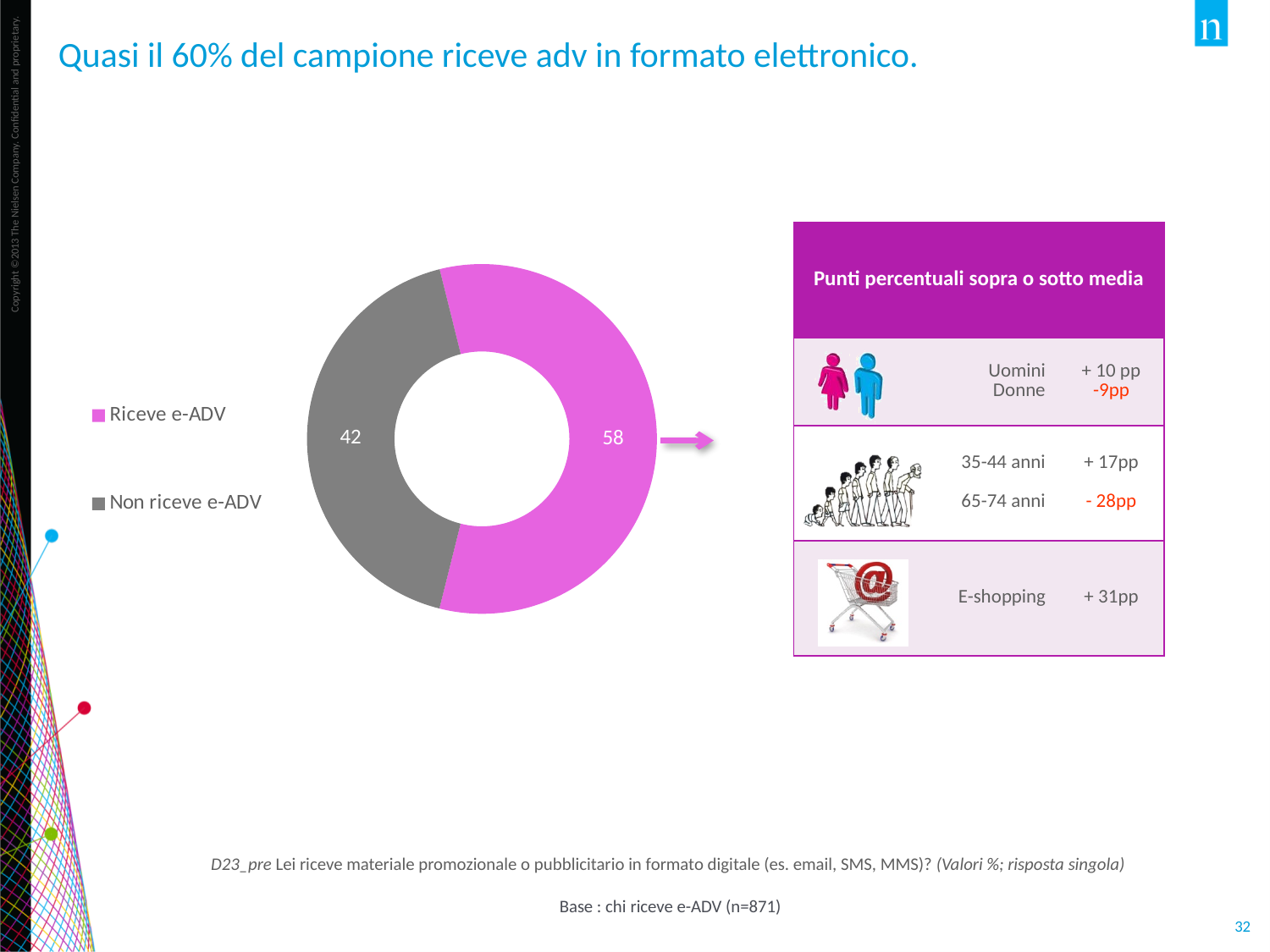
Is the value for "Riceve e-ADV" larger or smaller than the value for "Non riceve e-ADV"? larger What colour represents "Non riceve e-ADV" in the donut chart? Grey What value is shown for "Non riceve e-ADV" in the donut chart? 42 How many categories does the donut chart show? 2 What colour represents "Riceve e-ADV" in the donut chart? Pink/magenta Which category has the larger share in the donut chart? Riceve e-ADV What value is shown for "Riceve e-ADV" in the donut chart? 58 What is the difference between the values for "Riceve e-ADV" and "Non riceve e-ADV"? 16 What is the total of the two values shown in the donut chart? 100 Which category has the smaller share in the donut chart? Non riceve e-ADV What kind of chart is shown on the slide? Donut (pie) chart